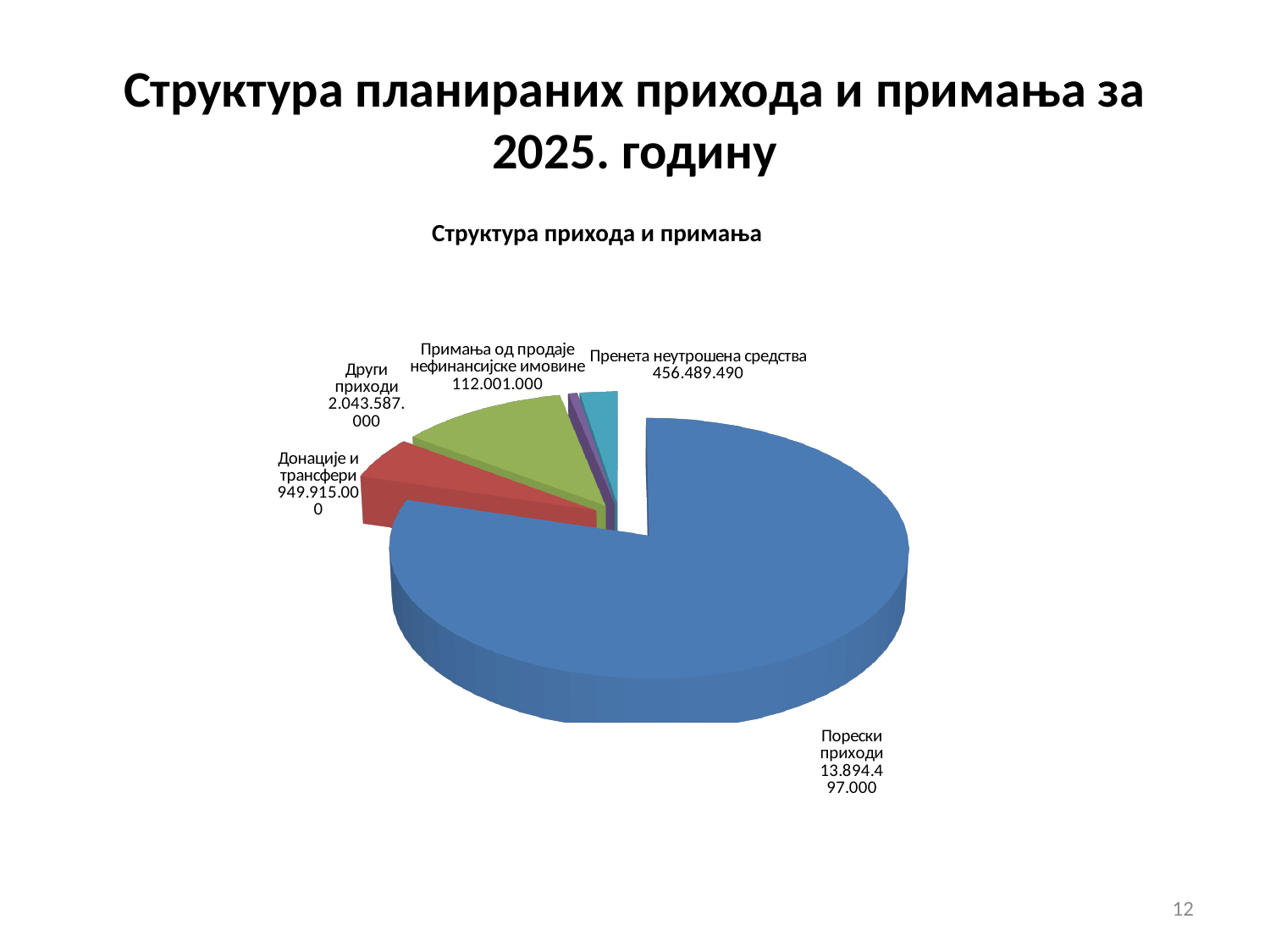
Which category has the largest slice? Порески приходи What is the value for Други приходи? 2.043.587.000 Which category has the smallest slice? Примања од продаје нефинансијске имовине What is the value for Порески приходи? 13.894.497.000 How many slices does the pie chart have? 5 What kind of chart is shown on the slide? Pie chart What is the title of the chart? Структура прихода и примања What is the value for Пренета неутрошена средства? 456.489.490 Which is larger, Други приходи or Донације и трансфери? Други приходи What is the value for Примања од продаје нефинансијске имовине? 112.001.000 What is the value for Донације и трансфери? 949.915.000 What is the difference between Други приходи and Донације и трансфери? 1.093.672.000